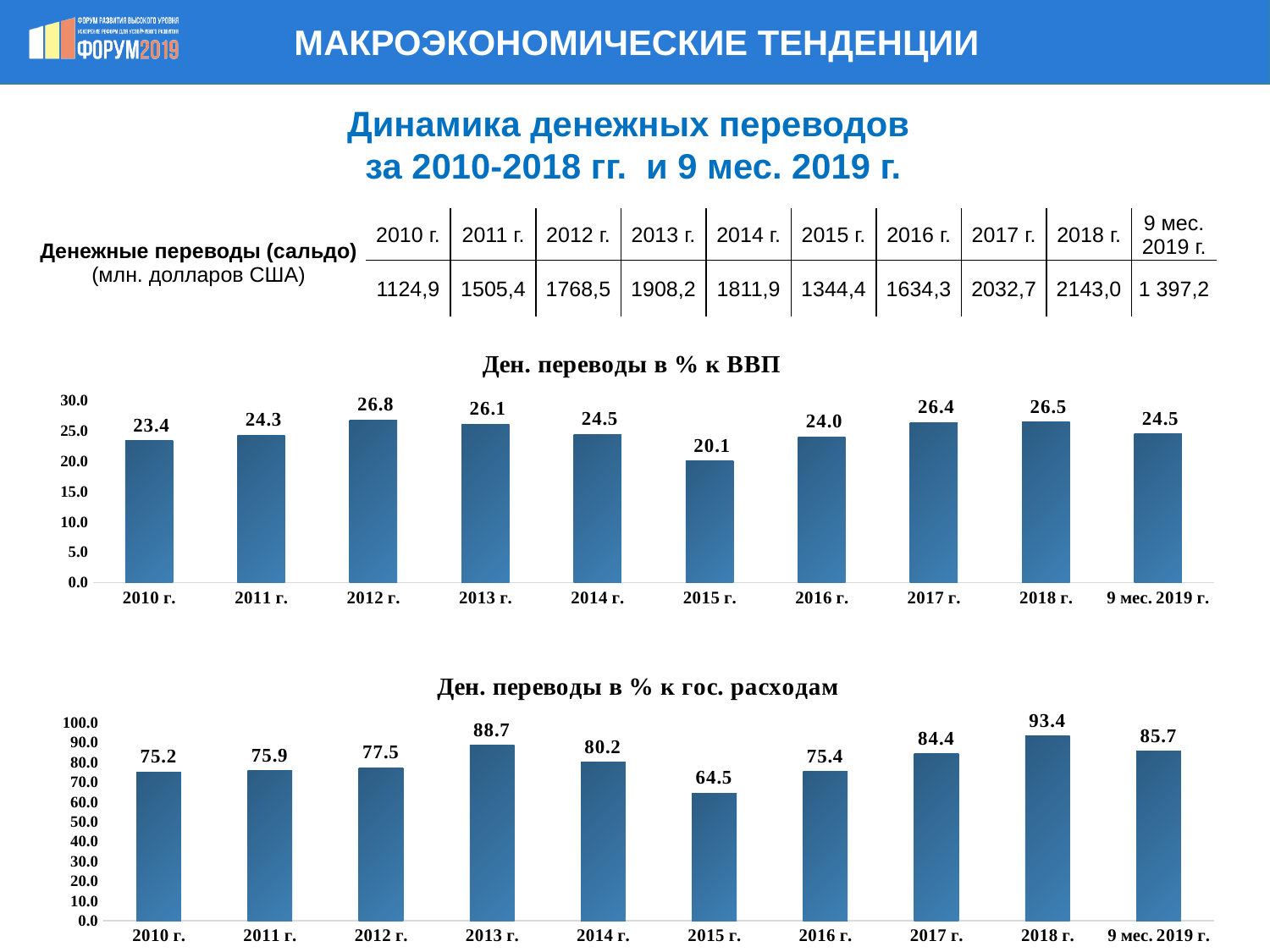
In the chart 'Ден. переводы в % к гос. расходам', what is the difference between the values for 2018 г. and 2015 г.? 28.9 In the chart 'Ден. переводы в % к ВВП', which category has the lowest value? 2015 г. In the chart 'Ден. переводы в % к гос. расходам', is the value for 2014 г. greater or less than 90.0? less In the chart 'Ден. переводы в % к ВВП', what is the difference between the values for 2012 г. and 2010 г.? 3.4 In the chart 'Ден. переводы в % к ВВП', do the values rise or fall from 2015 г. to 2018 г.? rise In the chart 'Ден. переводы в % к ВВП', how many categories are shown on the x axis? 10 In the chart 'Ден. переводы в % к ВВП', which category has the highest value? 2012 г. In the chart 'Ден. переводы в % к гос. расходам', what is the value for 2018 г.? 93.4 What kind of chart is 'Ден. переводы в % к гос. расходам'? bar chart In the chart 'Ден. переводы в % к ВВП', what is the value for 2015 г.? 20.1 In the chart 'Ден. переводы в % к гос. расходам', which category has the lowest value? 2015 г. In the chart 'Ден. переводы в % к гос. расходам', which is larger, the value for 2013 г. or the value for 2017 г.? 2013 г.